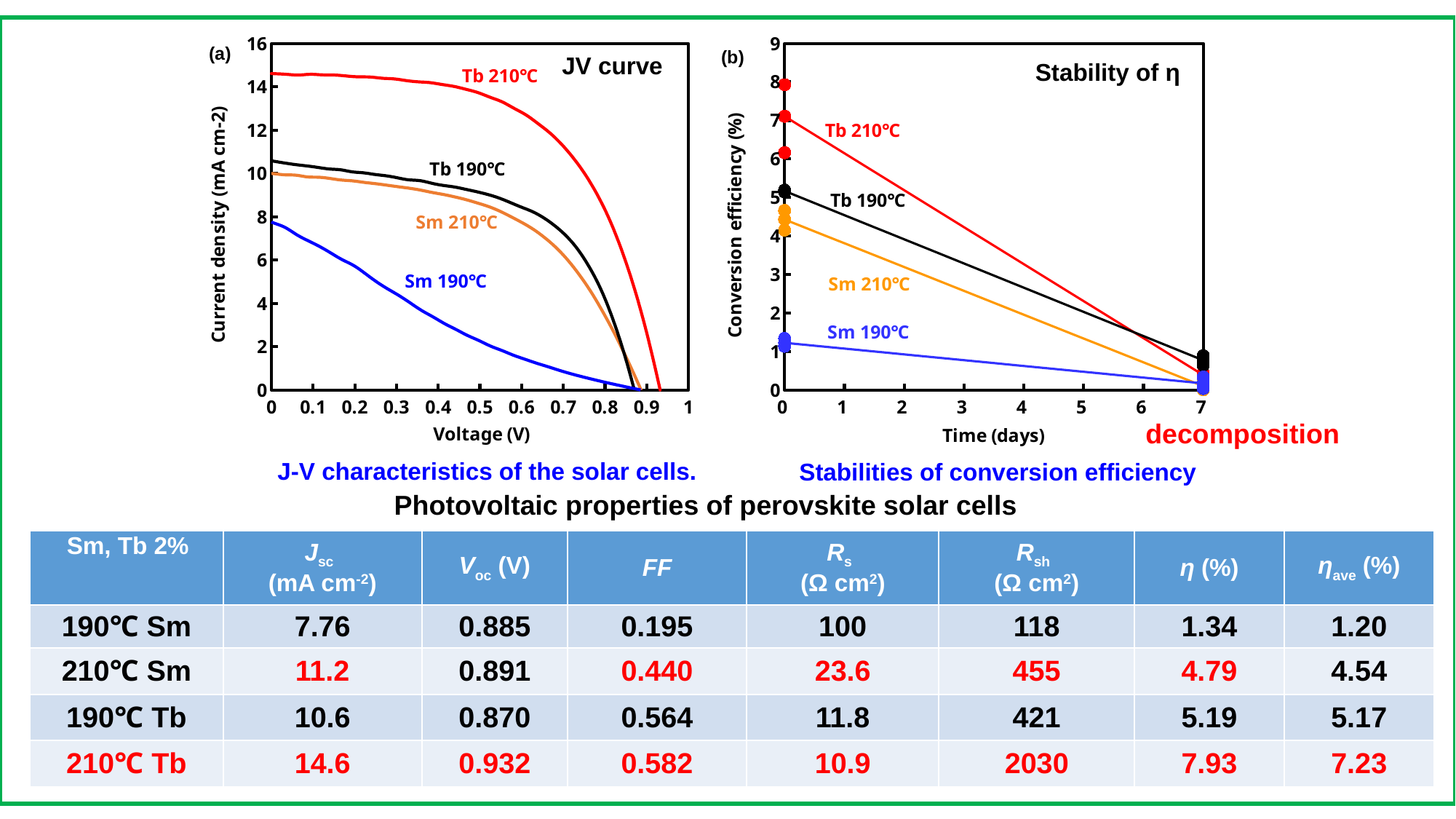
How many curves are plotted in the JV curve chart (a)? 4 In the Stability of η chart (b), is the conversion efficiency of Sm 190°C at day 0 greater or less than 2? less In the JV curve chart (a), does the current density rise or fall as voltage increases? fall In the JV curve chart (a), which sample has the lowest current density at 0 V? Sm 190°C In the JV curve chart (a), which sample has the highest current density at 0 V? Tb 210°C In the Stability of η chart (b), does the conversion efficiency rise or fall from day 0 to day 7? fall In the JV curve chart (a), is the current density of Sm 190°C at 0 V greater or less than 10? less In the Stability of η chart (b), which sample has the highest conversion efficiency at day 0? Tb 210°C What kind of chart is the JV curve chart (a)? line chart In the JV curve chart (a), is the current density of Tb 210°C at 0 V greater or less than 12? greater What is the y-axis label of the JV curve chart (a)? Current density (mA cm-2) What is the x-axis label of the Stability of η chart (b)? Time (days)